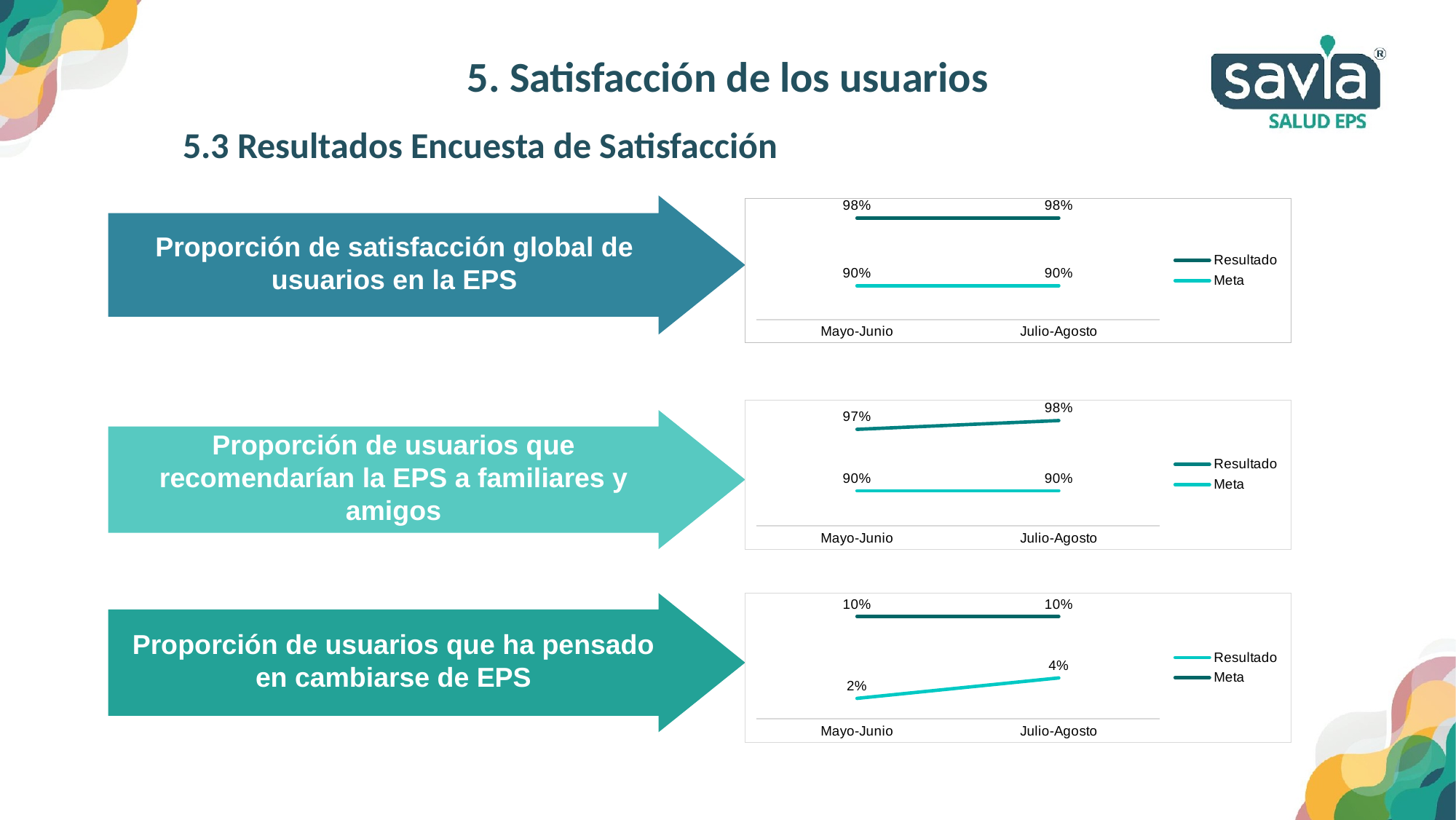
In the top chart (Proporción de satisfacción global de usuarios en la EPS), what is the Meta value for Julio-Agosto? 90% In the bottom chart (Proporción de usuarios que ha pensado en cambiarse de EPS), which is larger for Julio-Agosto, Resultado or Meta? Meta What kind of chart is the middle chart (Proporción de usuarios que recomendarían la EPS a familiares y amigos)? line chart How many series does the legend of the top chart list? 2 In the middle chart (Proporción de usuarios que recomendarían la EPS a familiares y amigos), what is the Resultado value for Mayo-Junio? 97% In the middle chart (Proporción de usuarios que recomendarían la EPS a familiares y amigos), what is the difference between the Resultado values for Julio-Agosto and Mayo-Junio? 1% In the top chart (Proporción de satisfacción global de usuarios en la EPS), what is the Resultado value for Mayo-Junio? 98% In the middle chart (Proporción de usuarios que recomendarían la EPS a familiares y amigos), does the Resultado series rise or fall from Mayo-Junio to Julio-Agosto? rise In the bottom chart (Proporción de usuarios que ha pensado en cambiarse de EPS), what is the Resultado value for Julio-Agosto? 4% In the top chart (Proporción de satisfacción global de usuarios en la EPS), what is the difference between the Resultado and Meta values for Julio-Agosto? 8% In the bottom chart (Proporción de usuarios que ha pensado en cambiarse de EPS), what is the Meta value for Mayo-Junio? 10% In the bottom chart (Proporción de usuarios que ha pensado en cambiarse de EPS), what is the difference between the Meta and Resultado values for Mayo-Junio? 8%